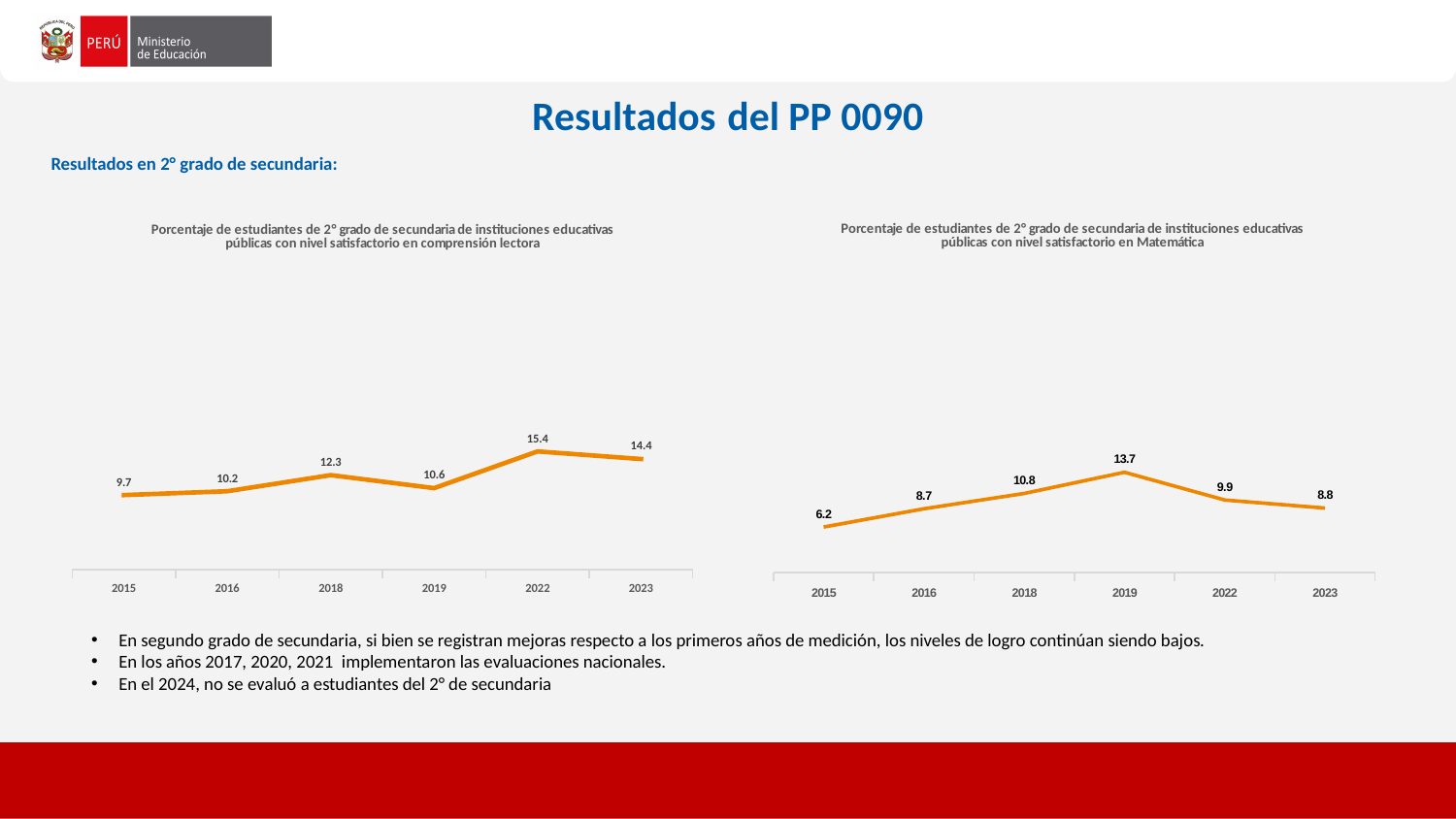
What is the title of the right chart? Porcentaje de estudiantes de 2° grado de secundaria de instituciones educativas públicas con nivel satisfactorio en Matemática In the right chart (Matemática), which is larger, the value for 2018 or the value for 2022? 2018 In the right chart (Matemática), does the value rise or fall from 2019 to 2023? fall In the left chart (comprensión lectora), what is the value for 2019? 10.6 In the left chart (comprensión lectora), how many years are plotted? 6 In the right chart (Matemática), what is the value for 2019? 13.7 In the left chart (comprensión lectora), what is the difference between the values for 2022 and 2023? 1.0 In the left chart (comprensión lectora), what is the value for 2015? 9.7 In the right chart (Matemática), what is the difference between the values for 2019 and 2023? 4.9 In the right chart (Matemática), which year has the lowest value? 2015 What kind of chart is the right chart (Matemática)? line chart In the left chart (comprensión lectora), which year has the highest value? 2022